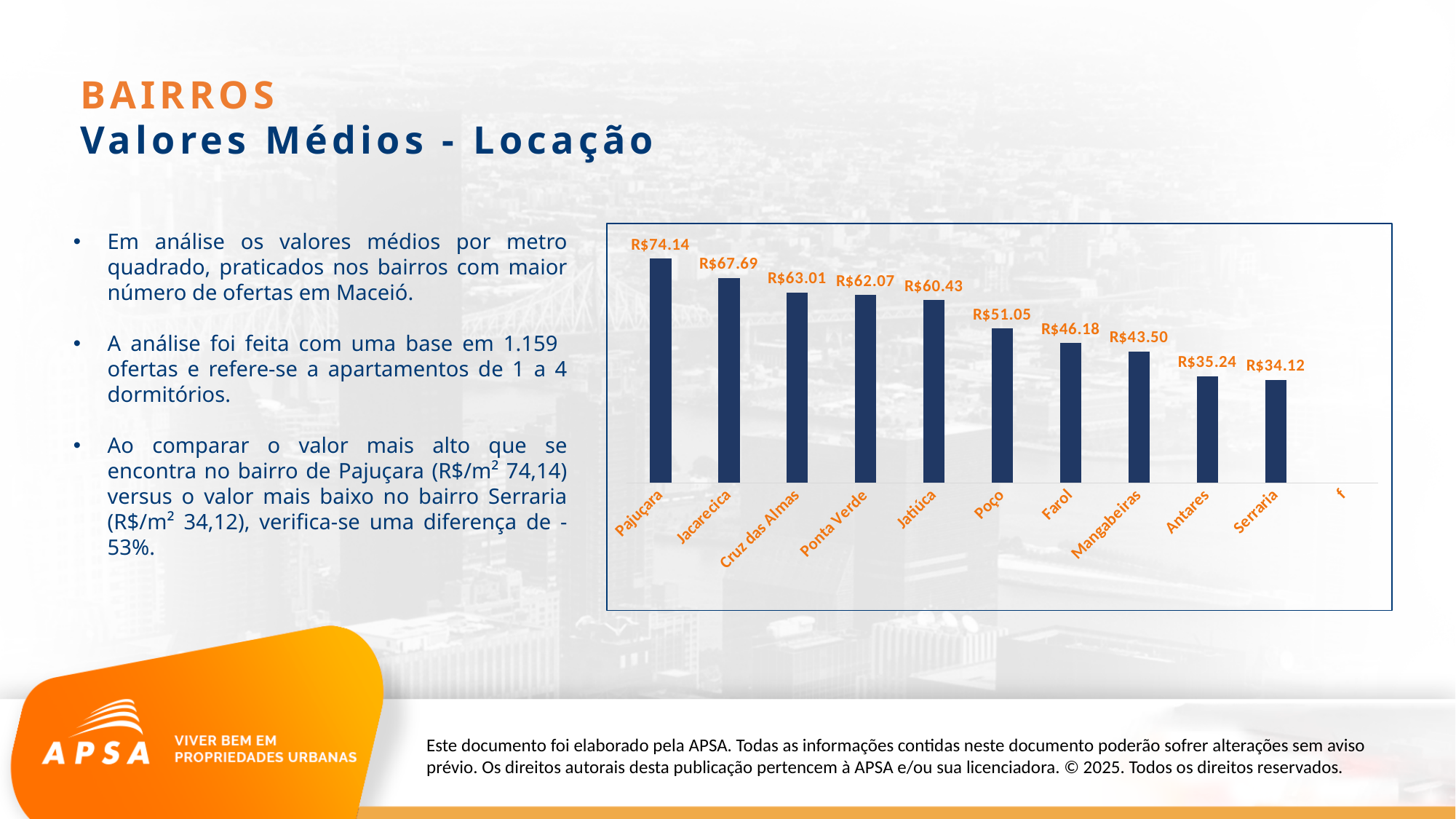
What is the value for Mangabeiras? R$43.50 Which bairro has the highest value? Pajuçara Which is larger, the value for Cruz das Almas or the value for Ponta Verde? Cruz das Almas How many bars are plotted in the chart? 10 What is the value for Pajuçara? R$74.14 What is the value for Antares? R$35.24 Which bairro has the lowest value? Serraria What kind of chart is shown on the slide? Bar chart What is the value for Jatiúca? R$60.43 What is the difference between the values for Poço and Farol? R$4.87 Do the values rise or fall from left to right across the chart? Fall What is the difference between the values for Pajuçara and Serraria? R$40.02